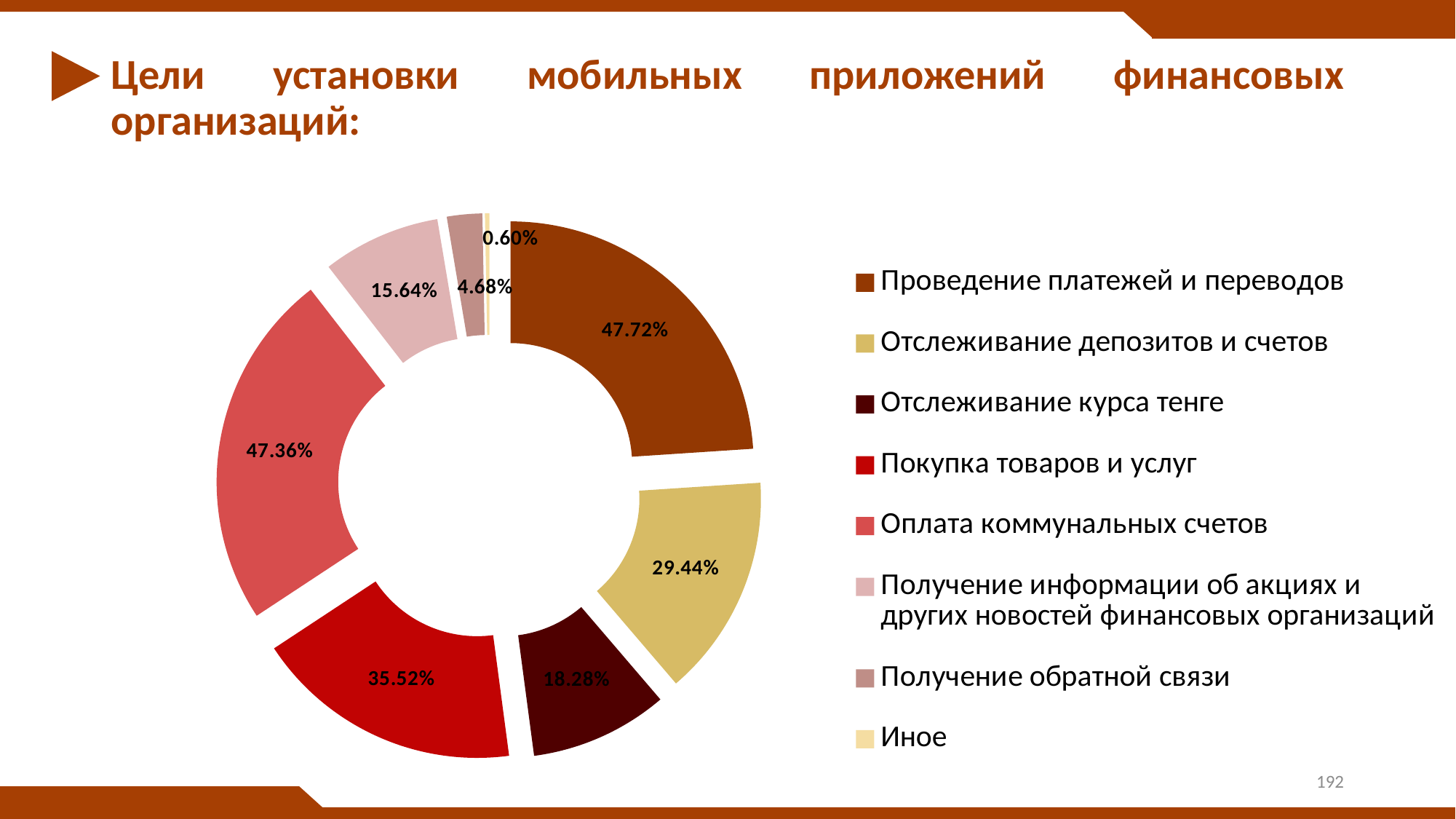
What is the difference between Покупка товаров и услуг and Отслеживание курса тенге? 17.24% Which category has the highest value? Проведение платежей и переводов How many categories does the chart show? 8 Which category has the lowest value? Иное What is the value for Отслеживание депозитов и счетов? 29.44% What is the value for Иное? 0.60% What type of chart is shown on the slide? Doughnut chart What is the value for Покупка товаров и услуг? 35.52% Which is larger: Оплата коммунальных счетов or Отслеживание депозитов и счетов? Оплата коммунальных счетов Which colour represents Отслеживание курса тенге in the legend? Dark red (maroon) What is the value for Получение обратной связи? 4.68% What is the value for Проведение платежей и переводов? 47.72%